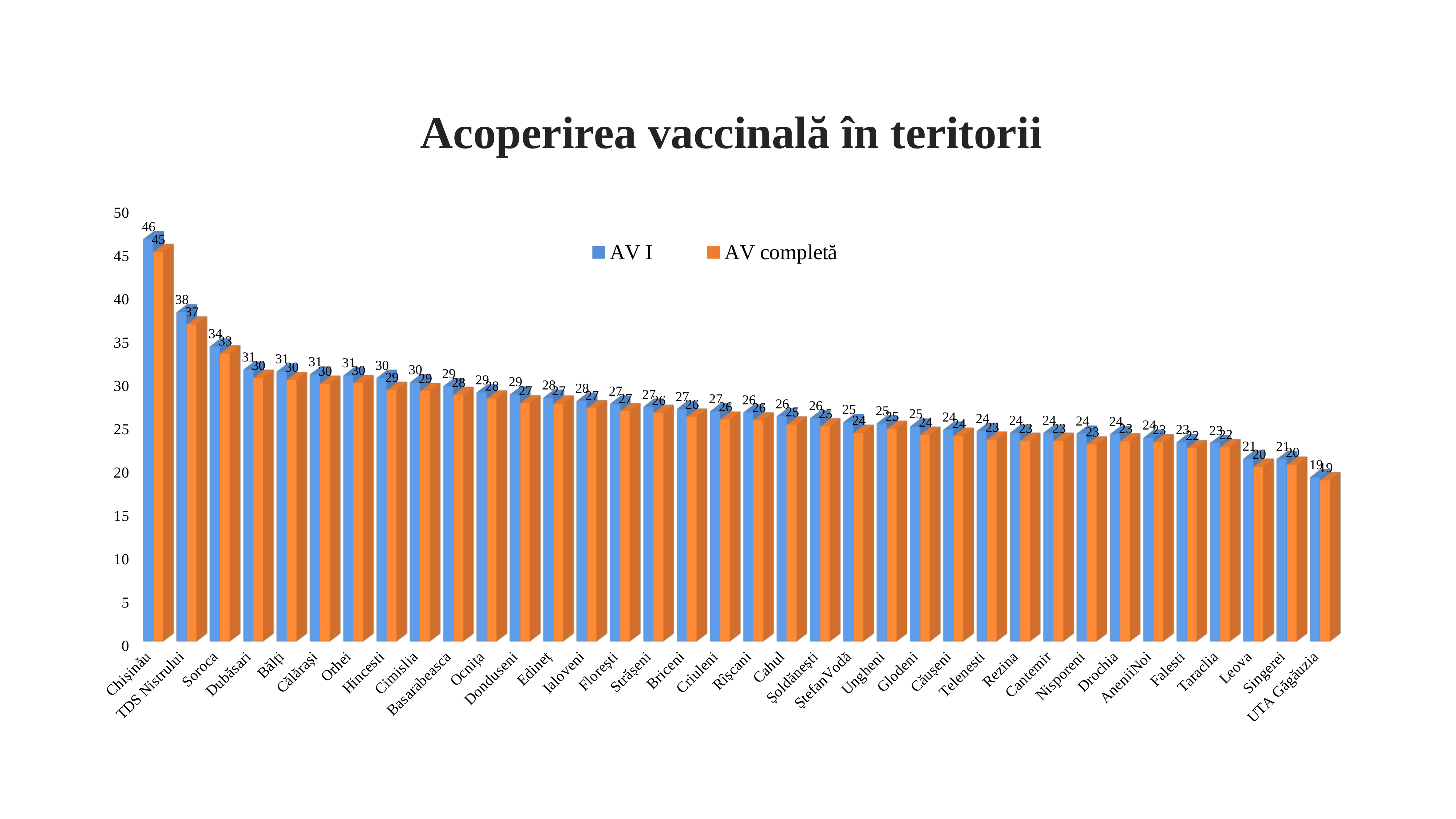
Which territory has the lowest AV completă value? UTA Găgăuzia Is the AV I value for TDS Nistrului greater or less than 35? greater Which is larger: the AV completă value for Soroca or the AV completă value for Dubăsari? Soroca Which territory has the highest AV I value? Chișinău Do the AV I values rise or fall from left to right along the x axis? fall What is the difference between the AV I values for Chișinău and TDS Nistrului? 8 How many territories are shown on the x axis? 36 What kind of chart is shown on the slide? bar chart What is the AV I value for Leova? 21 What is the AV completă value for Soroca? 33 What is the AV I value for Chișinău? 46 How many series does the legend list? 2